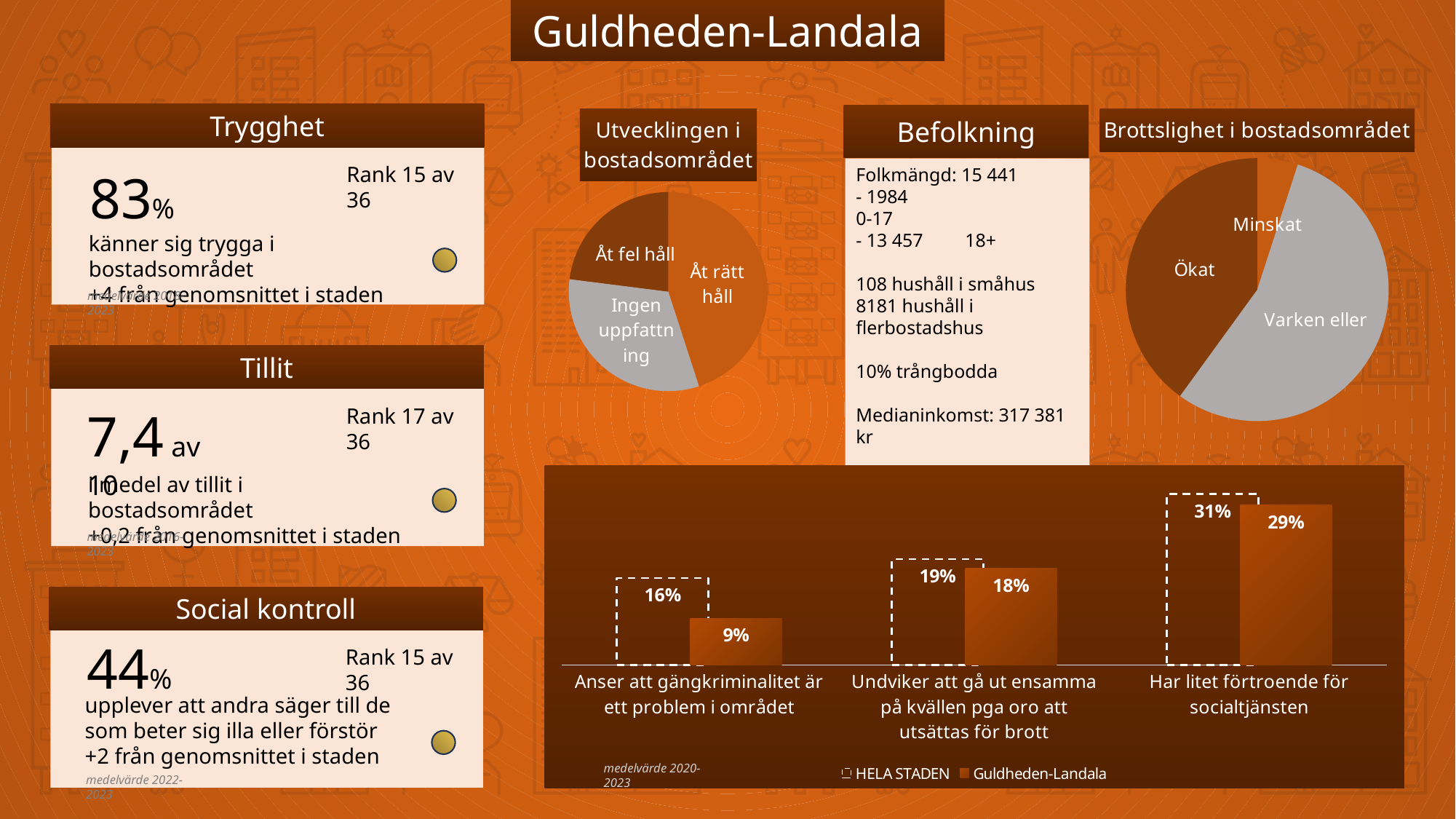
How many slices does the 'Brottslighet i bostadsområdet' pie chart have? 3 In the bar chart at the bottom, which is larger for 'Har litet förtroende för socialtjänsten': HELA STADEN or Guldheden-Landala? HELA STADEN In the bar chart at the bottom, what is the difference between HELA STADEN and Guldheden-Landala for 'Anser att gängkriminalitet är ett problem i området'? 7% How many categories are shown in the bar chart at the bottom? 3 In the 'Utvecklingen i bostadsområdet' pie chart, which slice is shown in grey? Ingen uppfattning In the bar chart at the bottom, what is the value for Guldheden-Landala for 'Undviker att gå ut ensamma på kvällen pga oro att utsättas för brott'? 18% In the bar chart at the bottom, which category has the highest value for Guldheden-Landala? Har litet förtroende för socialtjänsten How many series does the legend of the bar chart at the bottom list? 2 In the bar chart at the bottom, what is the value for Guldheden-Landala for 'Anser att gängkriminalitet är ett problem i området'? 9% In the bar chart at the bottom, what is the value for HELA STADEN for 'Har litet förtroende för socialtjänsten'? 31% What kind of chart is 'Utvecklingen i bostadsområdet'? Pie chart In the bar chart at the bottom, which category has the lowest value for HELA STADEN? Anser att gängkriminalitet är ett problem i området